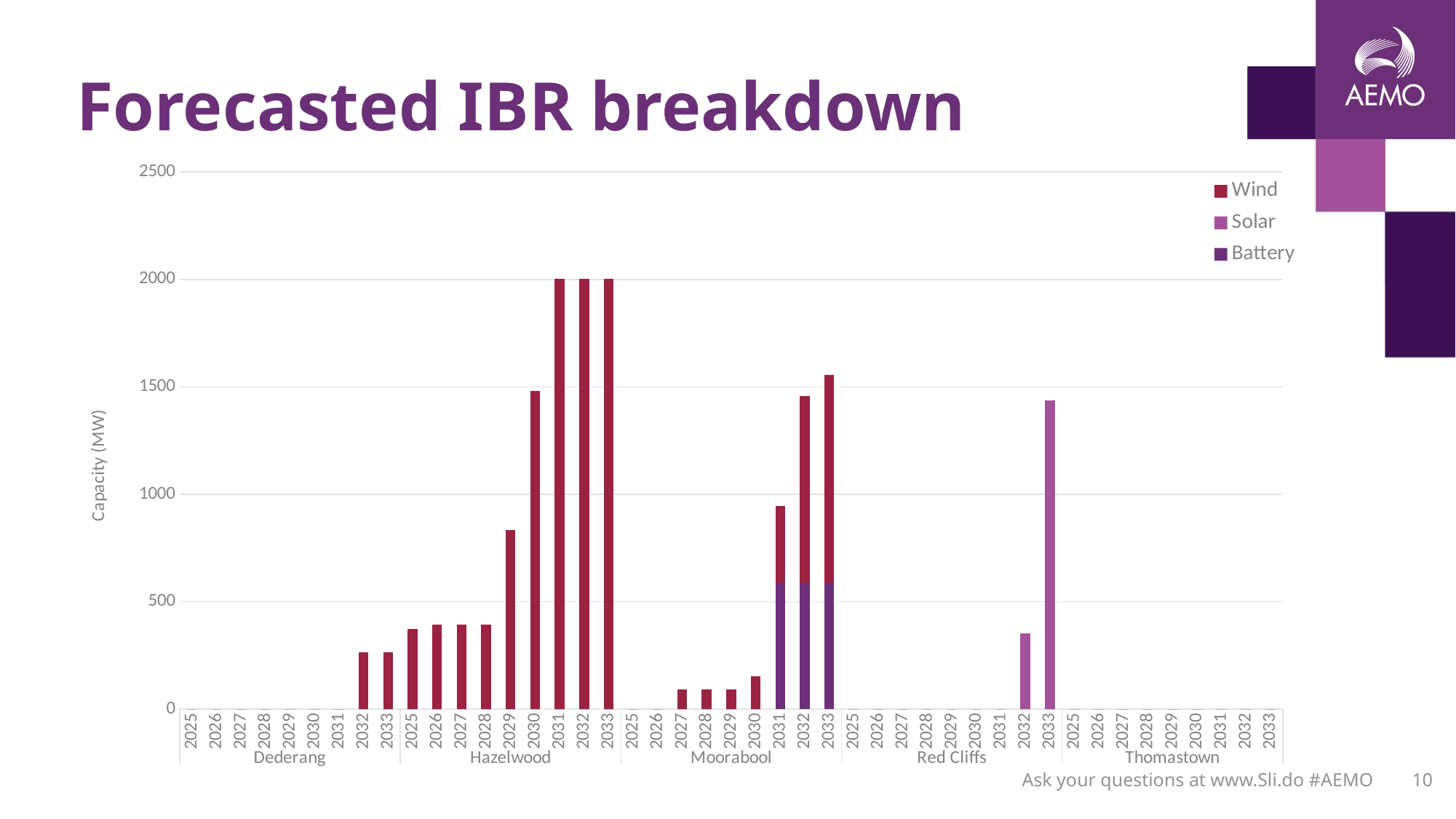
What are the series named in the legend? Wind, Solar, Battery Is the value for Moorabool in 2031 greater or less than 1000? less Is the value for Dederang in 2032 greater or less than 500? less Is the value for Red Cliffs in 2033 greater or less than 1000? greater What kind of chart is shown on the slide? Stacked bar chart Which region shows no bars at all across 2025 to 2033? Thomastown How many regions are shown along the x axis? 5 How many series does the legend list? 3 Do the Hazelwood values rise or fall from 2025 to 2033? rise Which region has the tallest bar on the chart? Hazelwood Which is larger, the total for Hazelwood in 2032 or the total for Moorabool in 2032? Hazelwood in 2032